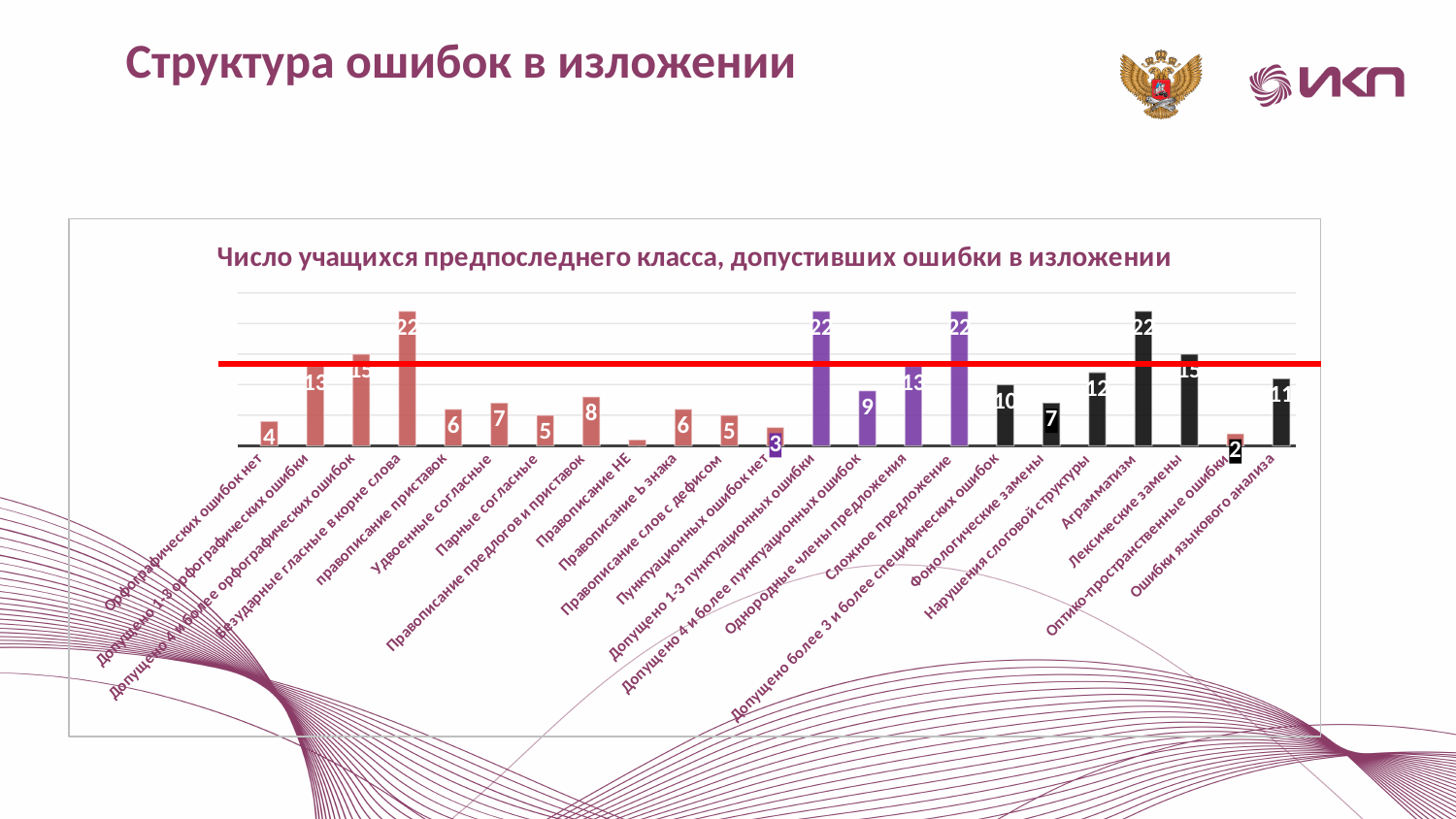
What is the value for Ошибки языкового анализа? 11 Which is larger: the value for Допущено 4 и более пунктуационных ошибок or the value for Допущено более 3 и более специфических ошибок? Допущено более 3 и более специфических ошибок What is the difference between the values for Сложное предложение and Однородные члены предложения? 9 What is the value for Правописание предлогов и приставок? 8 What is the value for Фонологические замены? 7 What is the title of the chart? Число учащихся предпоследнего класса, допустивших ошибки в изложении What kind of chart is shown on the slide? Bar chart What is the difference between the values for Лексические замены and Нарушения слоговой структуры? 3 What is the value for Допущено 4 и более пунктуационных ошибок? 9 What is the value for Безударные гласные в корне слова? 22 How many categories are shown on the chart? 23 What is the highest value shown on the chart? 22